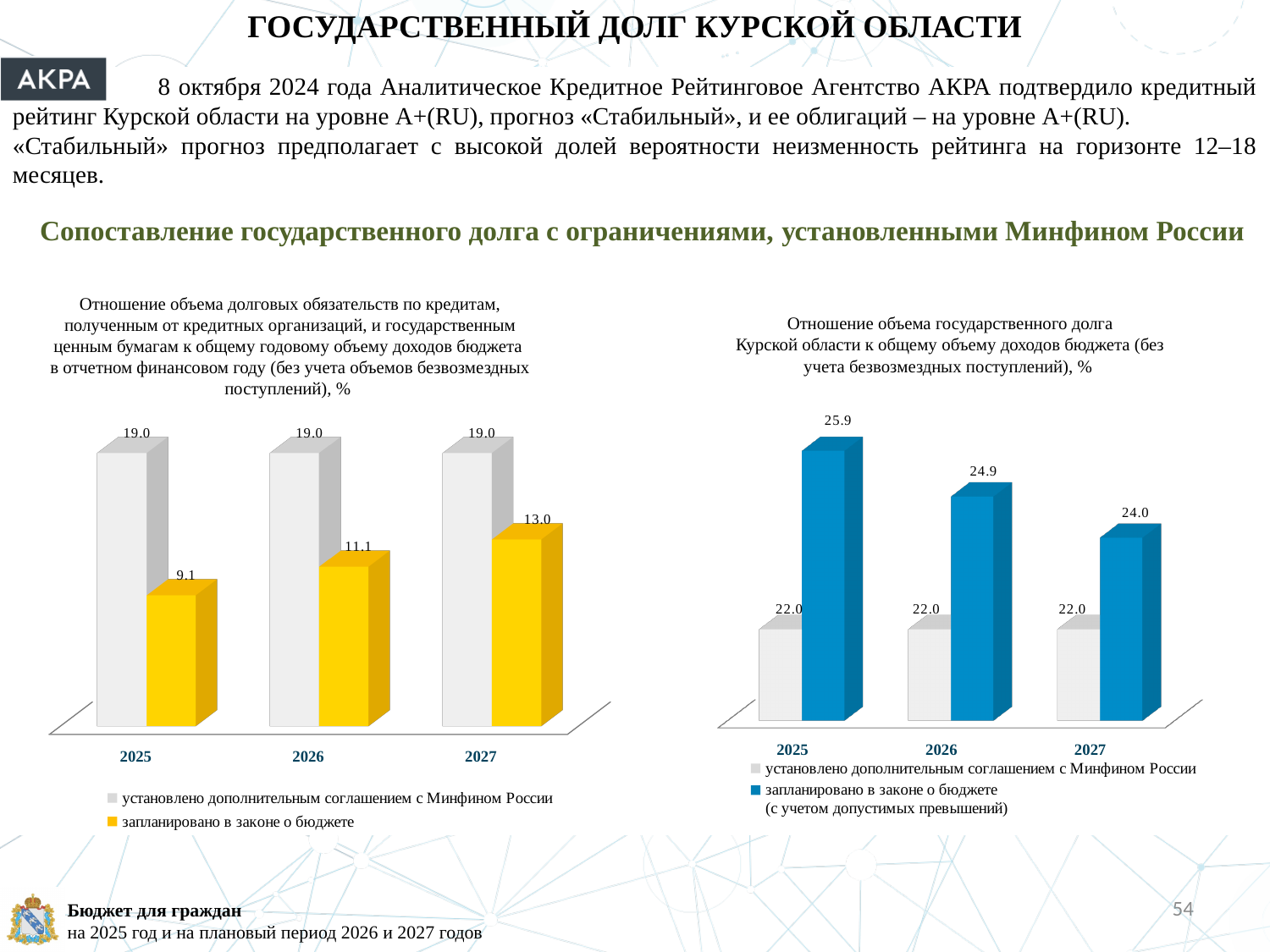
Какого типа правая диаграмма? столбчатая (bar chart) На правой диаграмме на сколько запланированное в законе о бюджете значение 2025 года превышает установленное дополнительным соглашением с Минфином России? 3.9 На правой диаграмме какое значение установлено дополнительным соглашением с Минфином России на 2025 год? 22.0 На левой диаграмме какое значение установлено дополнительным соглашением с Минфином России на 2027 год? 19.0 На левой диаграмме в каком году значение, запланированное в законе о бюджете, наибольшее? 2027 На правой диаграмме в каком году значение, запланированное в законе о бюджете, наименьшее? 2027 На правой диаграмме как меняются значения, запланированные в законе о бюджете, с 2025 по 2027 год? снижаются На правой диаграмме (отношение объема государственного долга Курской области к доходам бюджета) какое значение запланировано в законе о бюджете на 2026 год? 24.9 На левой диаграмме на сколько значение, установленное дополнительным соглашением с Минфином России, превышает запланированное в законе о бюджете в 2026 году? 7.9 На левой диаграмме как меняются значения, запланированные в законе о бюджете, с 2025 по 2027 год? растут На левой диаграмме (отношение объема долговых обязательств по кредитам и ценным бумагам к доходам бюджета) какое значение запланировано в законе о бюджете на 2025 год? 9.1 Сколько серий указано в легенде левой диаграммы? 2